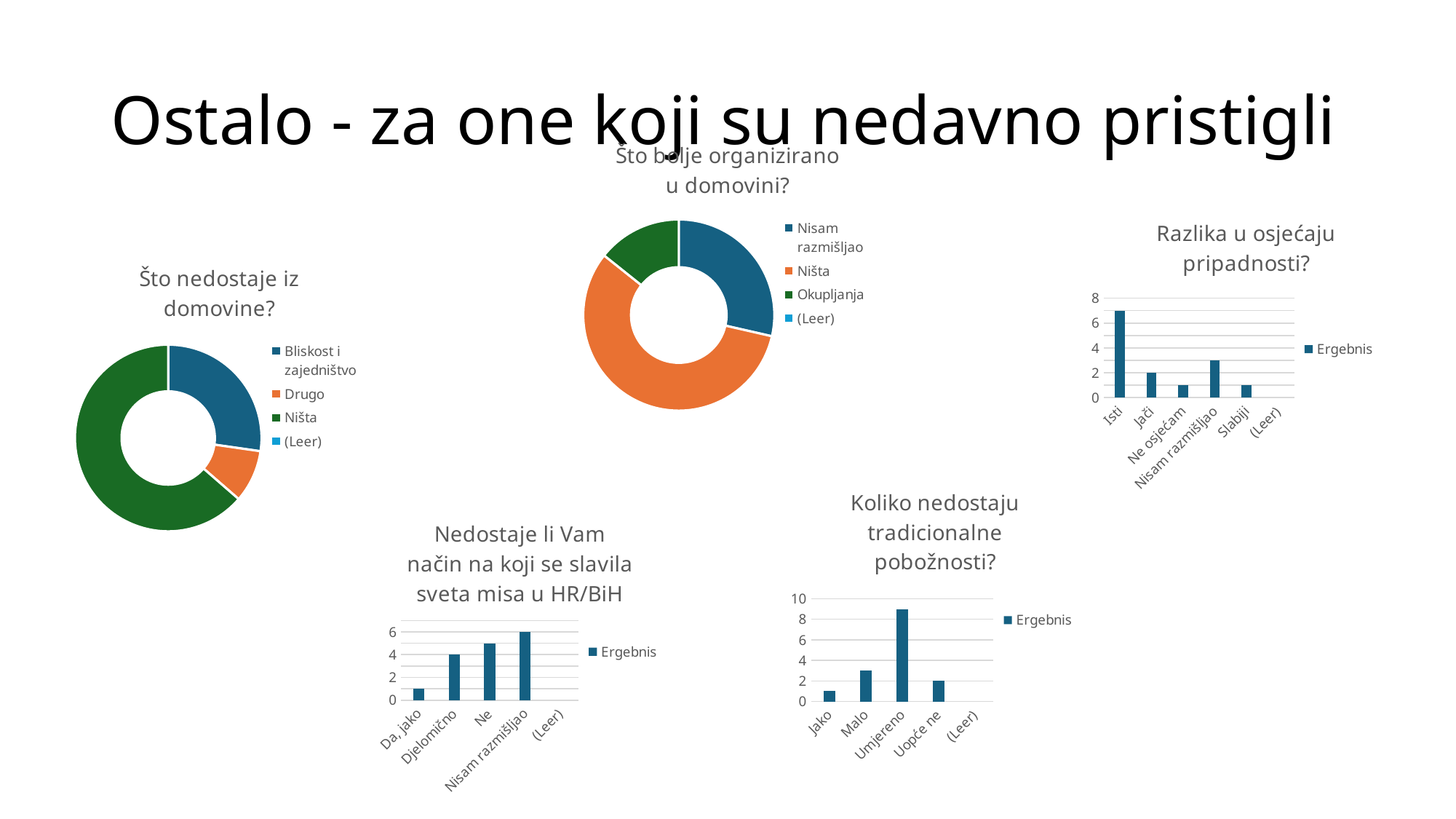
In the chart 'Razlika u osjećaju pripadnosti?', which category has the highest value? Isti In the chart 'Što nedostaje iz domovine?', which category has the largest slice? Ništa In the chart 'Razlika u osjećaju pripadnosti?', what is the value for 'Jači'? 2 In the chart 'Nedostaje li Vam način na koji se slavila sveta misa u HR/BiH', what is the difference between 'Nisam razmišljao' and 'Djelomično'? 2 In the chart 'Nedostaje li Vam način na koji se slavila sveta misa u HR/BiH', what is the value for 'Nisam razmišljao'? 6 In the chart 'Koliko nedostaju tradicionalne pobožnosti?', which category has the highest value? Umjereno What kind of chart is 'Što bolje organizirano u domovini?'? Doughnut chart In the chart 'Koliko nedostaju tradicionalne pobožnosti?', is the value for 'Umjereno' greater or less than 8? greater How many categories are shown on the x axis of the chart 'Razlika u osjećaju pripadnosti?'? 6 In the chart 'Razlika u osjećaju pripadnosti?', is the value for 'Isti' greater or less than 6? greater In the chart 'Koliko nedostaju tradicionalne pobožnosti?', what is the value for 'Uopće ne'? 2 In the chart 'Nedostaje li Vam način na koji se slavila sveta misa u HR/BiH', which is larger, 'Djelomično' or 'Ne'? Ne